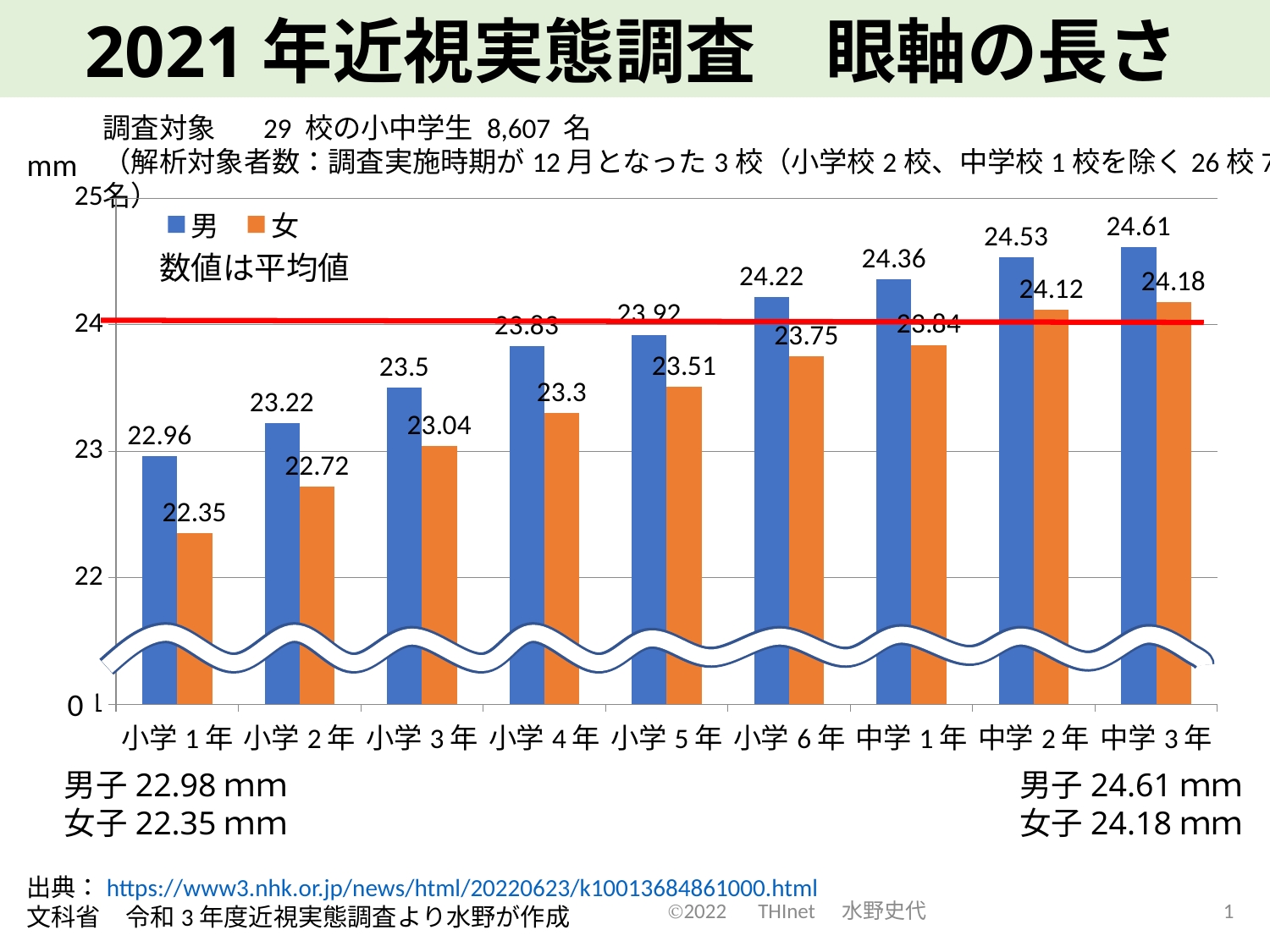
What is the difference between the 男 and 女 values in 小学2年? 0.5 What is the difference between the 男 and 女 values in 中学3年? 0.43 Is the value for 女 in 小学6年 greater or less than 24? less Which is larger: the 男 value in 小学5年 or the 女 value in 小学6年? 男 in 小学5年 What is the value for 男 in 中学2年? 24.53 What is the value for 女 in 中学3年? 24.18 How many series does the legend list? 2 Which grade has the lowest value for 女? 小学1年 Which grade has the highest value for 男? 中学3年 How many grade categories are shown on the x axis? 9 What is the value for 女 in 小学3年? 23.04 What is the value for 男 in 小学6年? 24.22